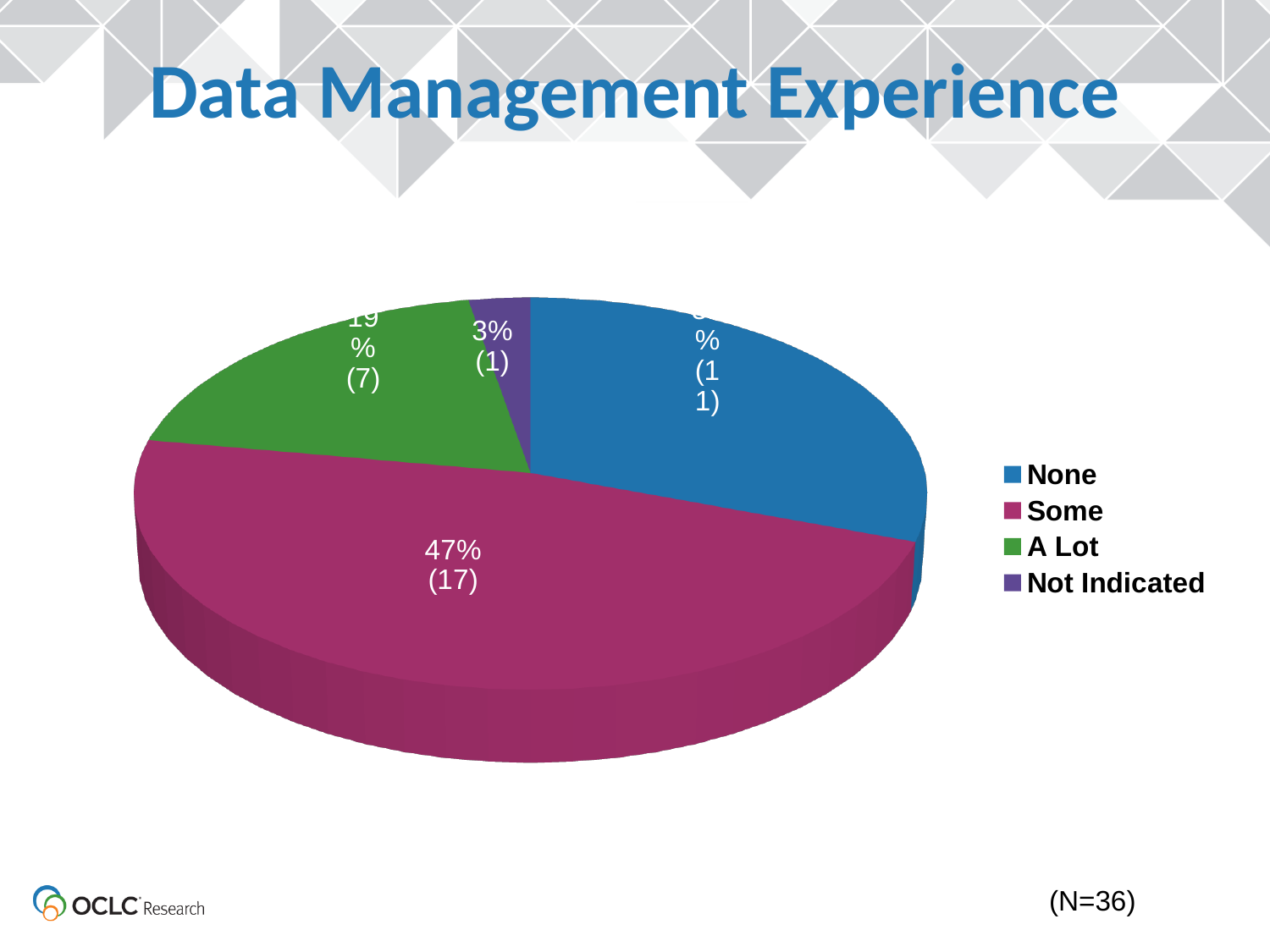
How many respondents are in the "Some" category? 17 How many respondents are in the "A Lot" category? 7 What percentage of the pie is the "Not Indicated" slice? 3% How many categories does the legend list? 4 How many more respondents are in "Some" than in "A Lot"? 10 What is the title of the chart? Data Management Experience What kind of chart is shown on the slide? pie chart Which category has the largest slice of the pie? Some Which category has the smallest slice of the pie? Not Indicated Which slice is larger, "A Lot" or "Not Indicated"? A Lot What percentage of the pie is the "Some" slice? 47% What percentage of the pie is the "A Lot" slice? 19%